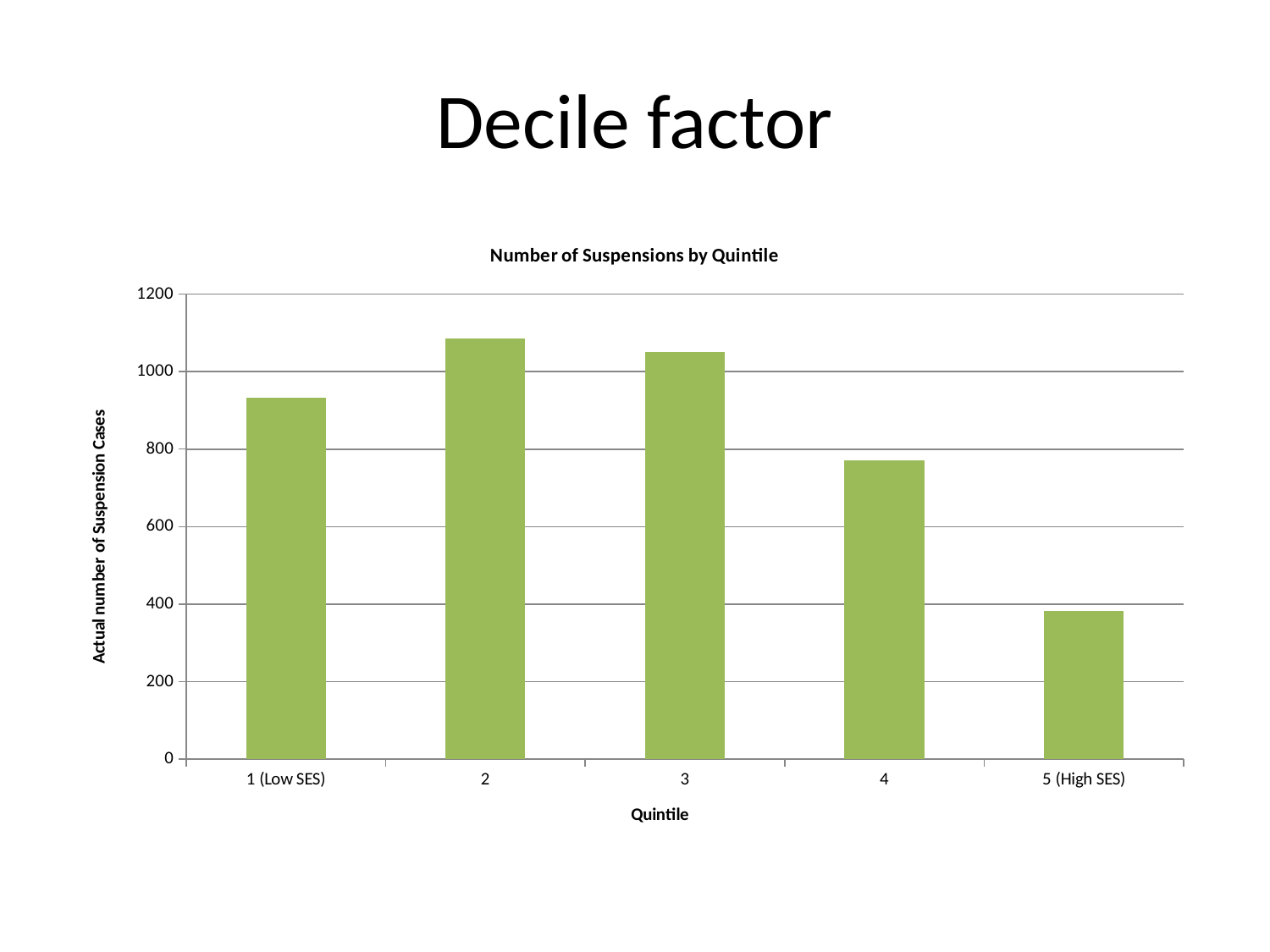
Which has more suspension cases, quintile 4 or 5 (High SES)? 4 Do the values rise or fall from quintile 3 to 5 (High SES)? fall How many quintile categories are plotted in the chart? 5 Which quintile has the highest number of suspension cases? 2 Which has more suspension cases, 1 (Low SES) or quintile 4? 1 (Low SES) Which quintile has the lowest number of suspension cases? 5 (High SES) Is the value for quintile 4 greater or less than 800? less Is the value for 1 (Low SES) greater or less than 800? greater Is the value for 5 (High SES) greater or less than 400? less What is the title of the chart? Number of Suspensions by Quintile What type of chart is shown on the slide? Bar chart